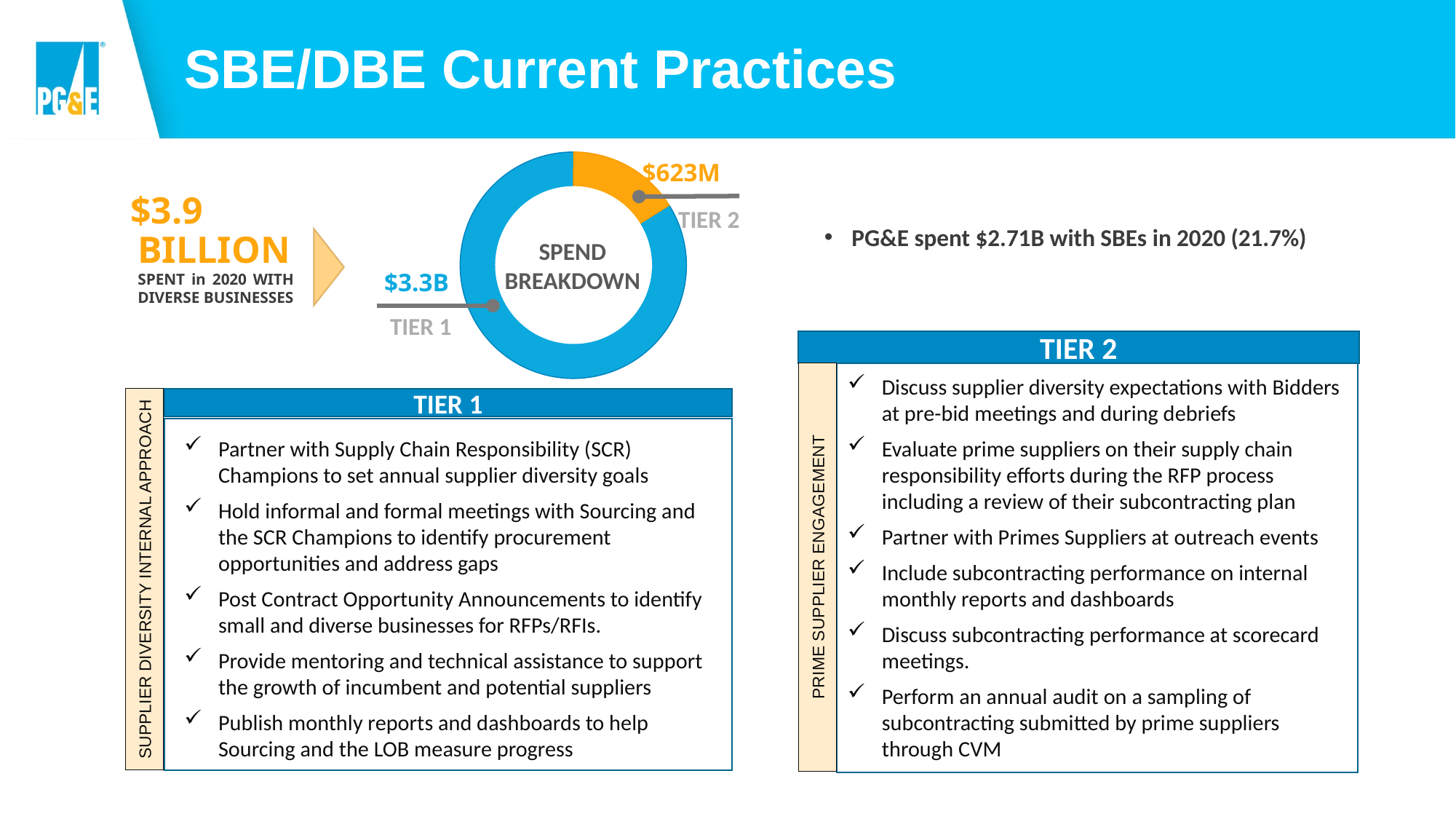
What is the title shown in the centre of the donut chart? SPEND BREAKDOWN In the Spend Breakdown chart, which tier has the larger spend? Tier 1 In the Spend Breakdown chart, what is the value for Tier 2? $623M How many slices does the Spend Breakdown chart have? 2 In the Spend Breakdown chart, which tier has the smaller spend? Tier 2 In the Spend Breakdown chart, what is the value for Tier 1? $3.3B What kind of chart is the Spend Breakdown chart? donut (pie) chart In the Spend Breakdown chart, what colour is the Tier 2 slice? orange In the Spend Breakdown chart, is the spend for Tier 1 larger or smaller than the spend for Tier 2? larger In the Spend Breakdown chart, does the Tier 2 slice take up more or less than half of the donut? less